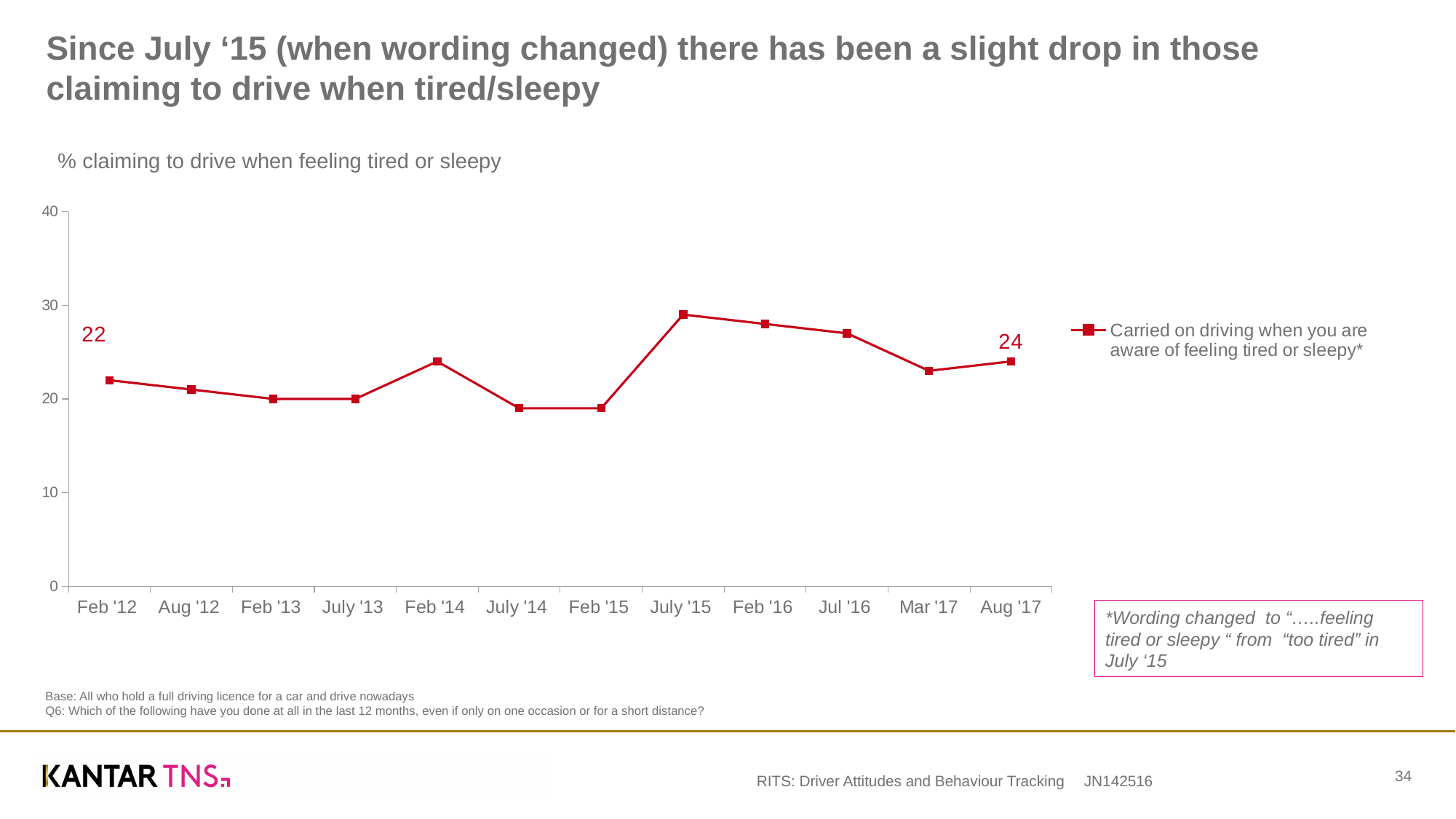
What is the difference between the values for Aug '17 and Feb '12? 2 How many time points are plotted on the x axis? 12 Which is larger, the value for Feb '12 or the value for Aug '17? Aug '17 Is the value for July '15 greater or less than 20? greater What is the legend entry for the plotted series? Carried on driving when you are aware of feeling tired or sleepy* What is the value for Aug '17? 24 What kind of chart is shown on the slide? line chart How many series does the legend list? 1 What is the value for Feb '12? 22 Do the values rise or fall from July '15 to Mar '17? fall Is the value for Feb '16 greater or less than 30? less Which time point has the highest value? July '15